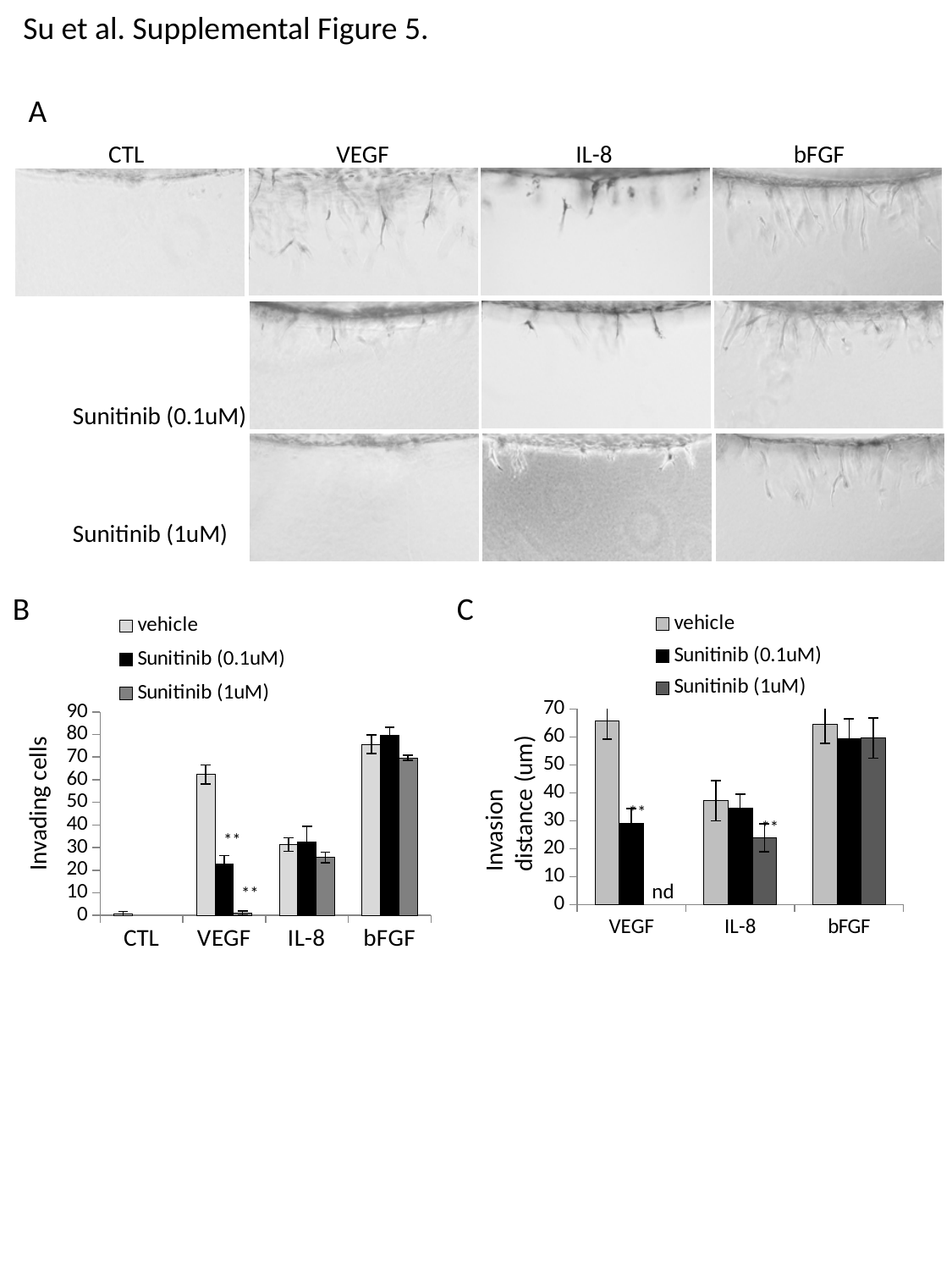
How many categories are shown on the x axis of chart B (Invading cells)? 4 In chart C (Invasion distance), is the vehicle value for VEGF greater or less than 60? greater In chart C (Invasion distance), is the Sunitinib (1uM) value for IL-8 greater or less than 30? less How many series does the legend of chart B (Invading cells) list? 3 How many categories are shown on the x axis of chart C (Invasion distance)? 3 In chart C (Invasion distance), what label is shown in place of the Sunitinib (1uM) bar for VEGF? nd In chart B (Invading cells), which category has the lowest vehicle value? CTL In chart B (Invading cells), for VEGF, which is larger: the vehicle value or the Sunitinib (0.1uM) value? vehicle In chart B (Invading cells), is the Sunitinib (0.1uM) value for VEGF greater or less than 30? less In chart B (Invading cells), which category has the highest vehicle value? bFGF What kind of chart is chart B (Invading cells)? bar chart